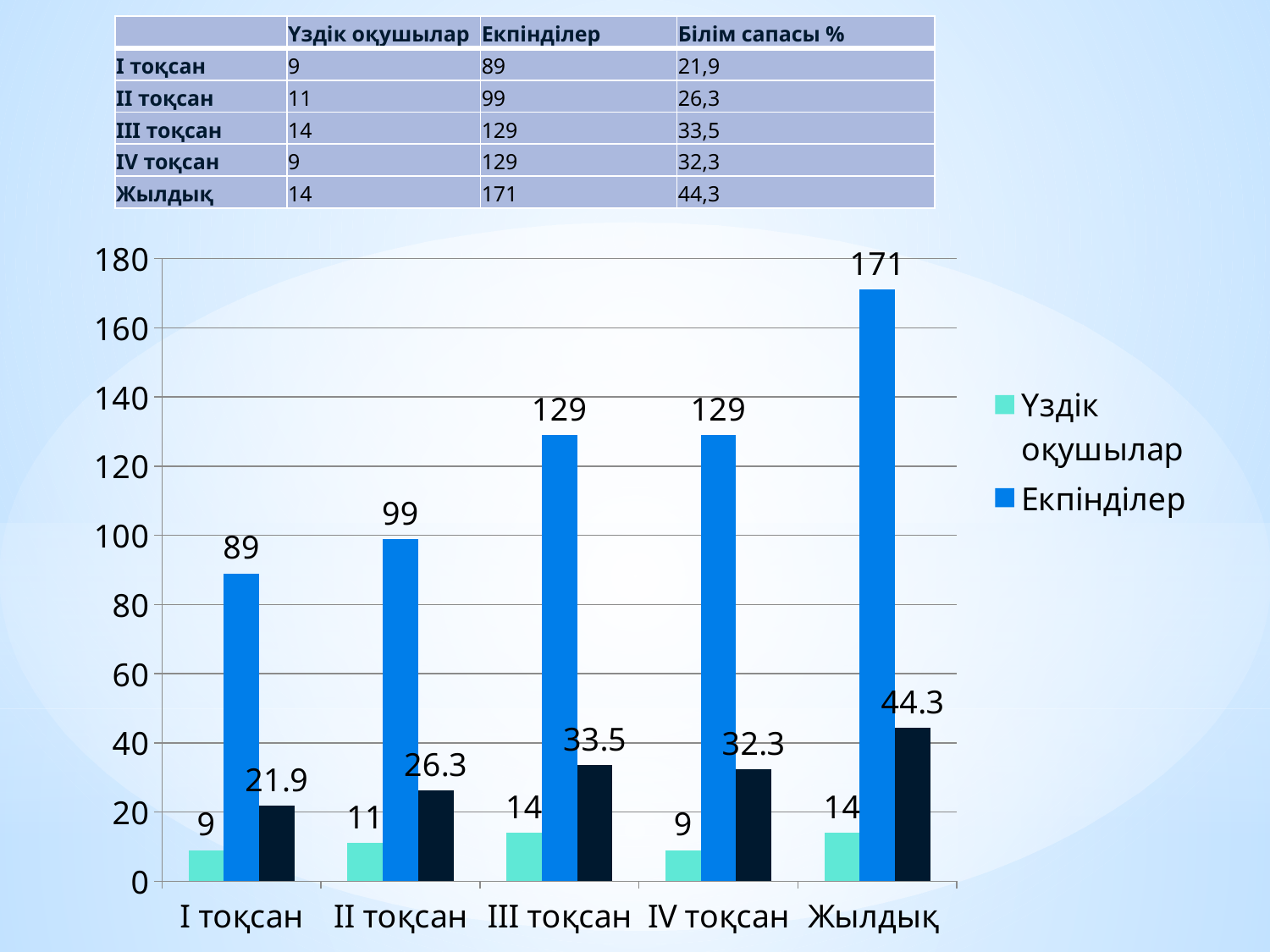
Which category has the lowest value for Екпінділер? I тоқсан What colour are the Екпінділер bars? blue What is the value for Үздік оқушылар in II тоқсан? 11 Which is larger, the Екпінділер value for I тоқсан or for II тоқсан? II тоқсан Do the Екпінділер values rise or fall from I тоқсан to Жылдық? rise Which category has the highest value for Екпінділер? Жылдық What is the value of the dark bar (Білім сапасы %) for Жылдық? 44.3 What is the value for Екпінділер in III тоқсан? 129 What type of chart is shown on the slide? bar chart What is the difference between the Екпінділер values for Жылдық and IV тоқсан? 42 How many series does the legend list? 2 How many categories are shown on the x axis? 5